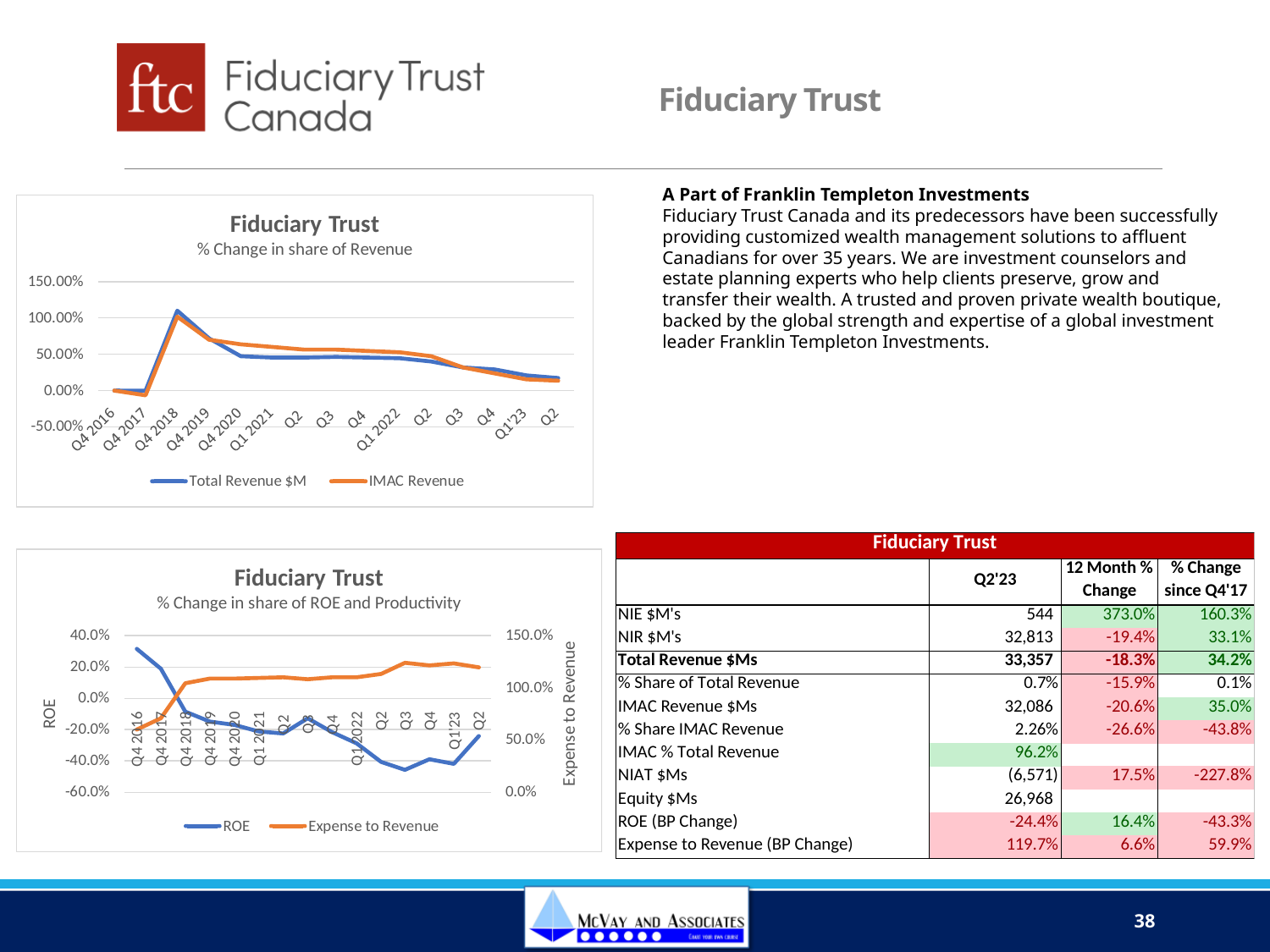
In the top-left chart (% Change in share of Revenue), is the Total Revenue $M value at Q4 2016 greater or less than 50.00%? less How many series does the legend of the bottom-left chart (% Change in share of ROE and Productivity) list? 2 What kind of chart is the top-left chart titled 'Fiduciary Trust % Change in share of Revenue'? Line chart In the top-left chart (% Change in share of Revenue), is the IMAC Revenue value at Q4 2018 greater or less than 50.00%? greater In the bottom-left chart (% Change in share of ROE and Productivity), is the ROE value at Q4 2016 greater or less than 20.0%? greater In the top-left chart (% Change in share of Revenue), at which quarter does the Total Revenue $M line reach its highest value? Q4 2018 What are the two series named in the legend of the top-left chart (% Change in share of Revenue)? Total Revenue $M and IMAC Revenue How many quarters are plotted along the x axis of the top-left chart (% Change in share of Revenue)? 15 In the top-left chart (% Change in share of Revenue), does the Total Revenue $M line rise or fall from Q4 2018 to the final Q2 point? fall What kind of chart is the bottom-left chart titled 'Fiduciary Trust % Change in share of ROE and Productivity'? Line chart How many series does the legend of the top-left chart (% Change in share of Revenue) list? 2